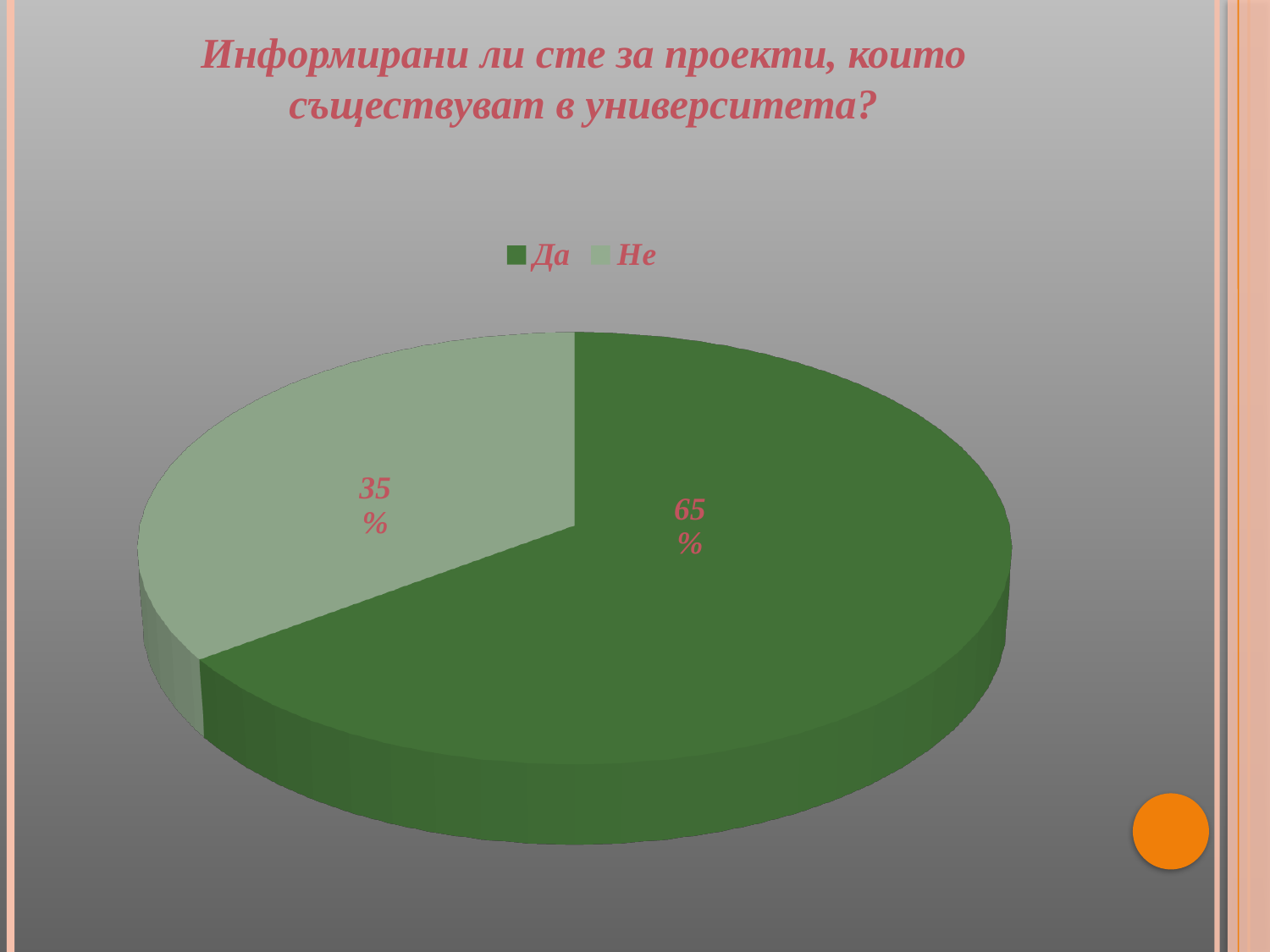
Which slice of the pie chart is the largest? Да What is the title of the chart on the slide? Информирани ли сте за проекти, които съществуват в университета? What percentage of the pie chart is labelled "Да"? 65% Which legend entry is shown in the darker green colour? Да What kind of chart is shown on the slide? Pie chart How many entries does the legend list? 2 What percentage of the pie chart is labelled "Не"? 35% What is the difference in percentage points between the "Да" and "Не" slices? 30 How many slices does the pie chart have? 2 What share of the pie does the "Не" slice represent? 35% Which slice of the pie chart is the smallest? Не Which slice is larger, "Да" or "Не"? Да